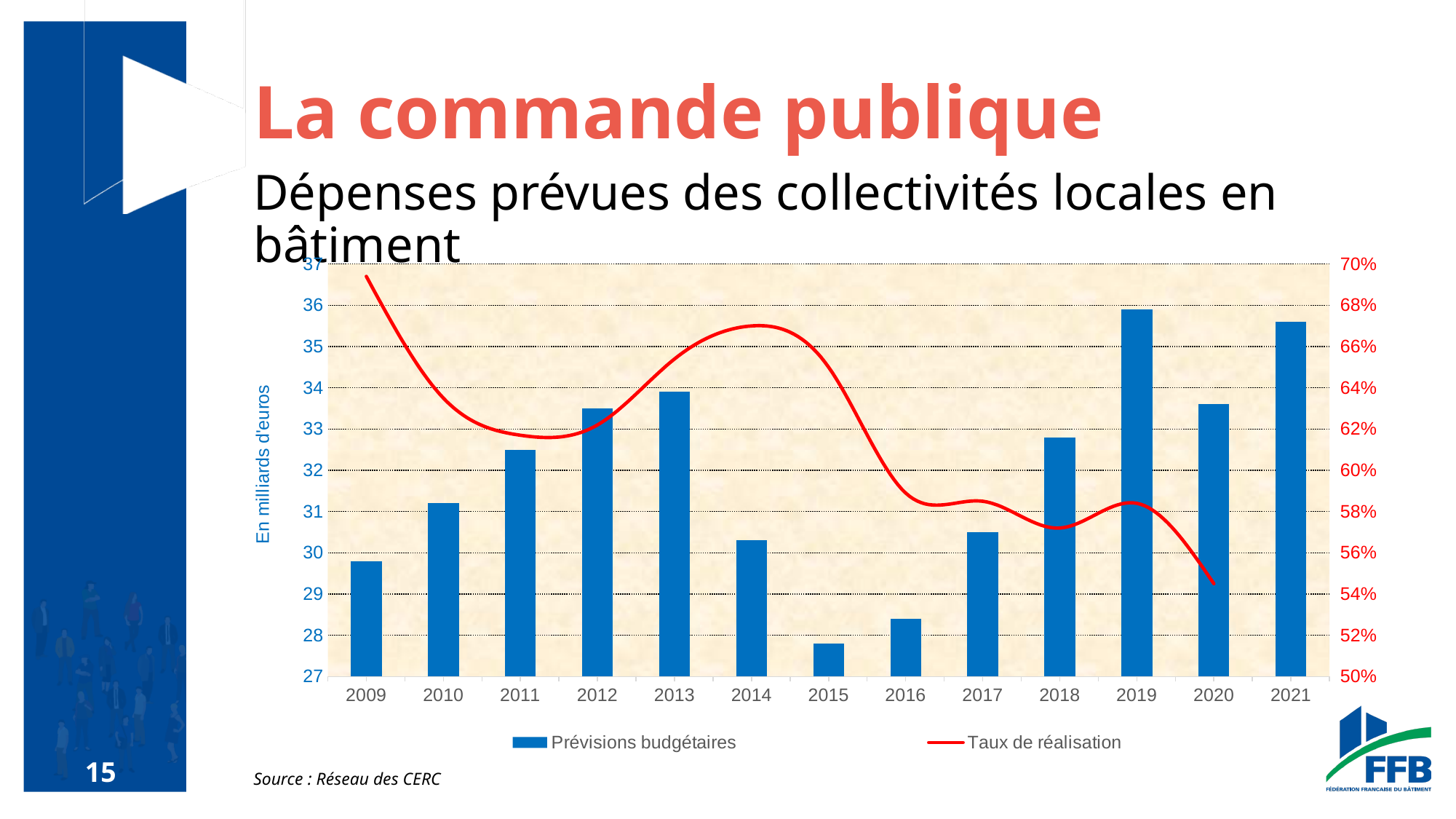
Which year has the lowest 'Prévisions budgétaires' bar? 2015 Is the 'Prévisions budgétaires' value for 2009 greater or less than 30? less Which year has a higher 'Prévisions budgétaires' bar, 2018 or 2017? 2018 Is the 'Taux de réalisation' value for 2020 greater or less than 56%? less How many series does the legend list? 2 Is the 'Prévisions budgétaires' value for 2019 greater or less than 35? greater What is the label of the left vertical axis? En milliards d'euros Does the 'Taux de réalisation' line overall rise or fall from 2009 to 2020? fall What kind of chart is used to show the 'Prévisions budgétaires' series? bar chart How many years are shown on the x axis? 13